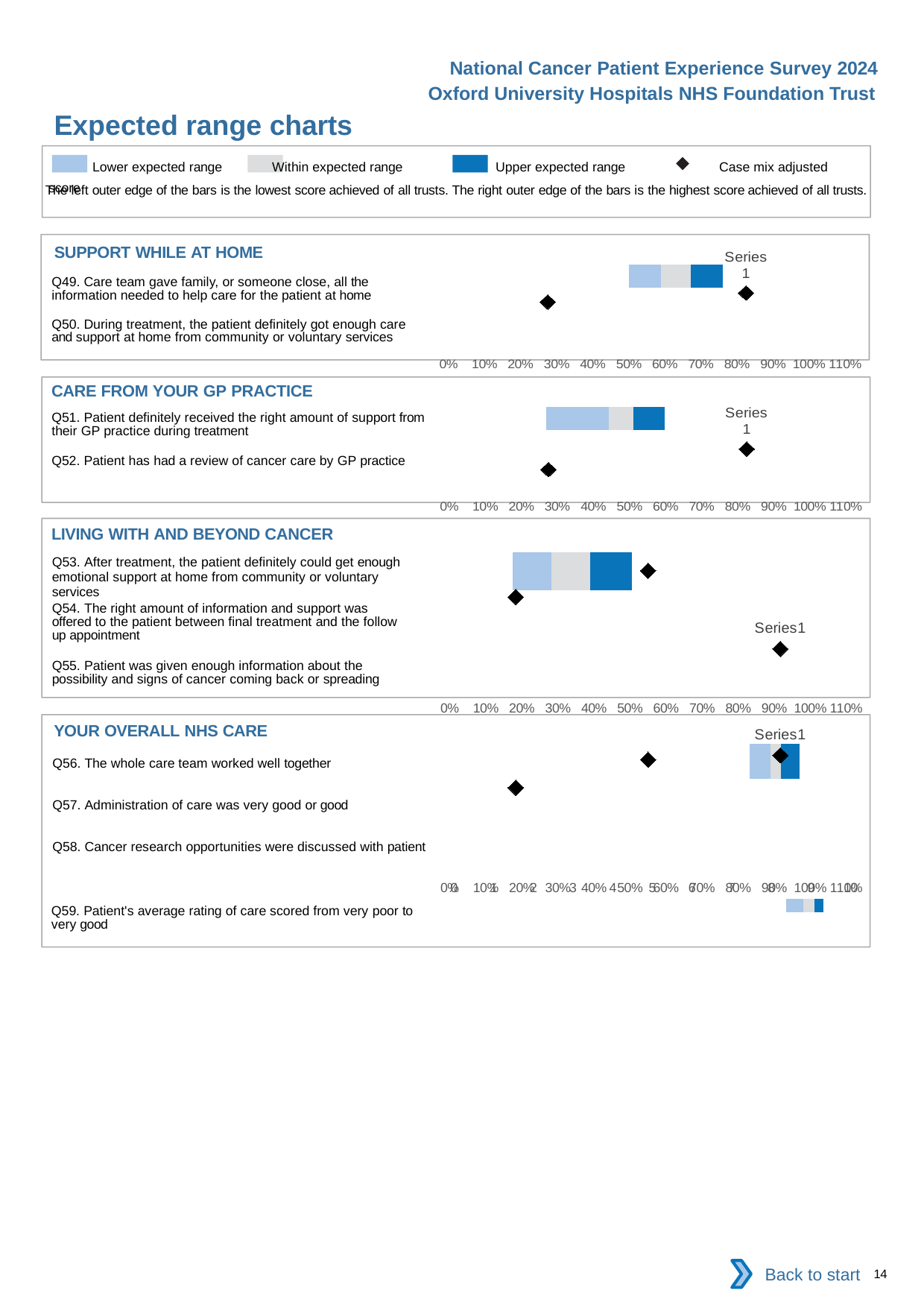
According to the legend, what does the black diamond marker represent? Case mix adjusted score In the YOUR OVERALL NHS CARE chart, is the diamond labelled "Series1" greater or less than 80%? greater How many entries does the legend at the top of the slide list? 4 In the LIVING WITH AND BEYOND CANCER chart, is the diamond labelled "Series1" greater or less than 80%? greater How many questions are listed in the YOUR OVERALL NHS CARE section? 4 In the SUPPORT WHILE AT HOME chart, is the leftmost diamond greater or less than 40%? less What is the highest tick shown on the x axis of the charts? 110% How many questions are listed in the LIVING WITH AND BEYOND CANCER section? 3 What kind of chart is used in the expected range charts on this slide? bar chart